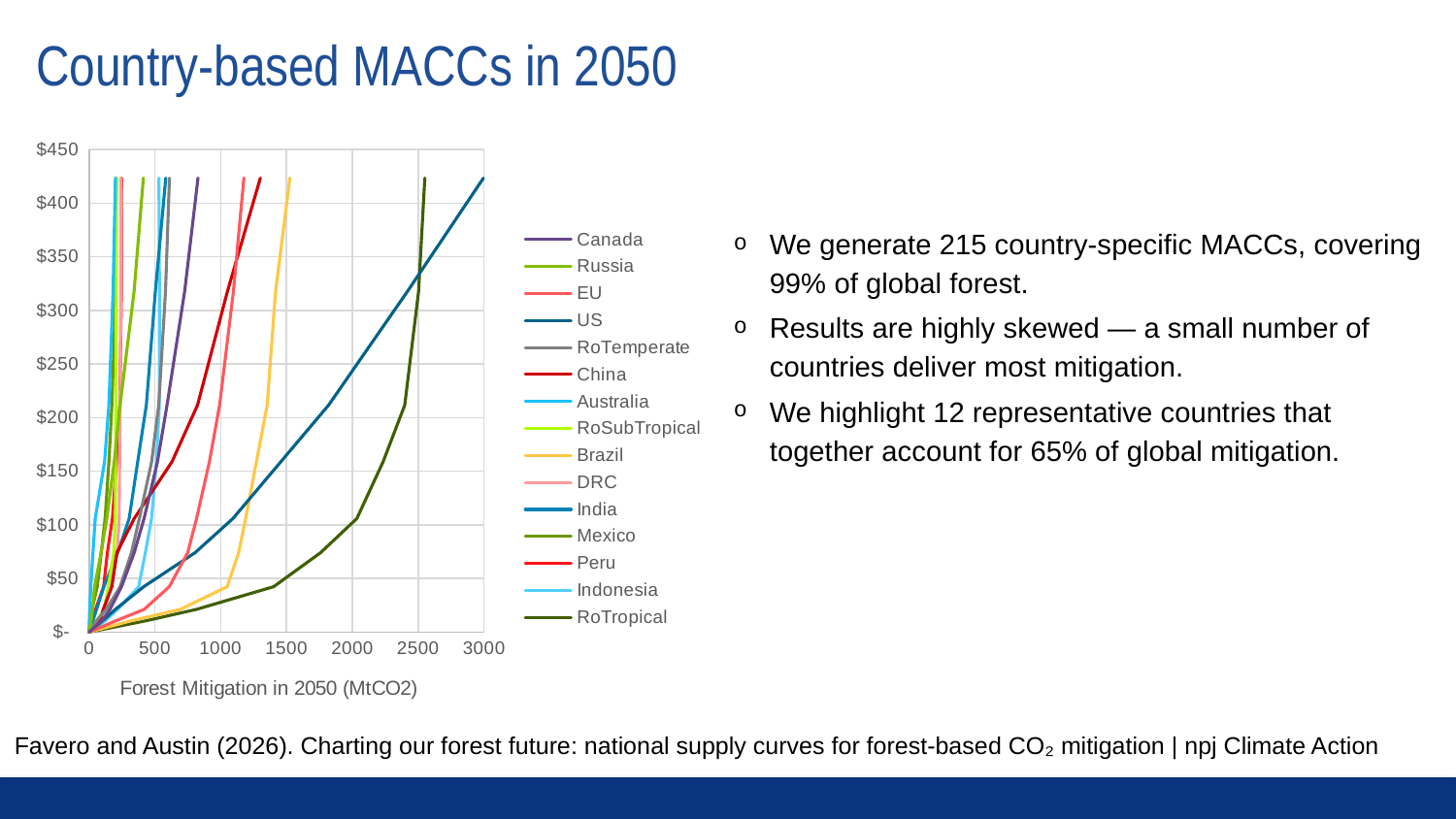
What is the first entry listed in the chart's legend? Canada What kind of chart is shown on the slide? line chart At the top of the chart (around $400), which reaches a larger forest mitigation value, Brazil or Canada? Brazil At the top of the chart (around $400), is the forest mitigation value for Brazil greater or less than 1000? greater What is the title of the chart's x axis? Forest Mitigation in 2050 (MtCO2) At the top of the chart (around $400), is the forest mitigation value for RoTropical greater or less than 2000? greater Do the curves rise or fall as forest mitigation increases along the x axis? rise At the top of the chart (around $400), is the forest mitigation value for Russia greater or less than 1000? less How many series does the chart's legend list? 15 At the top of the chart (around $400), which reaches a larger forest mitigation value, RoTropical or Brazil? RoTropical